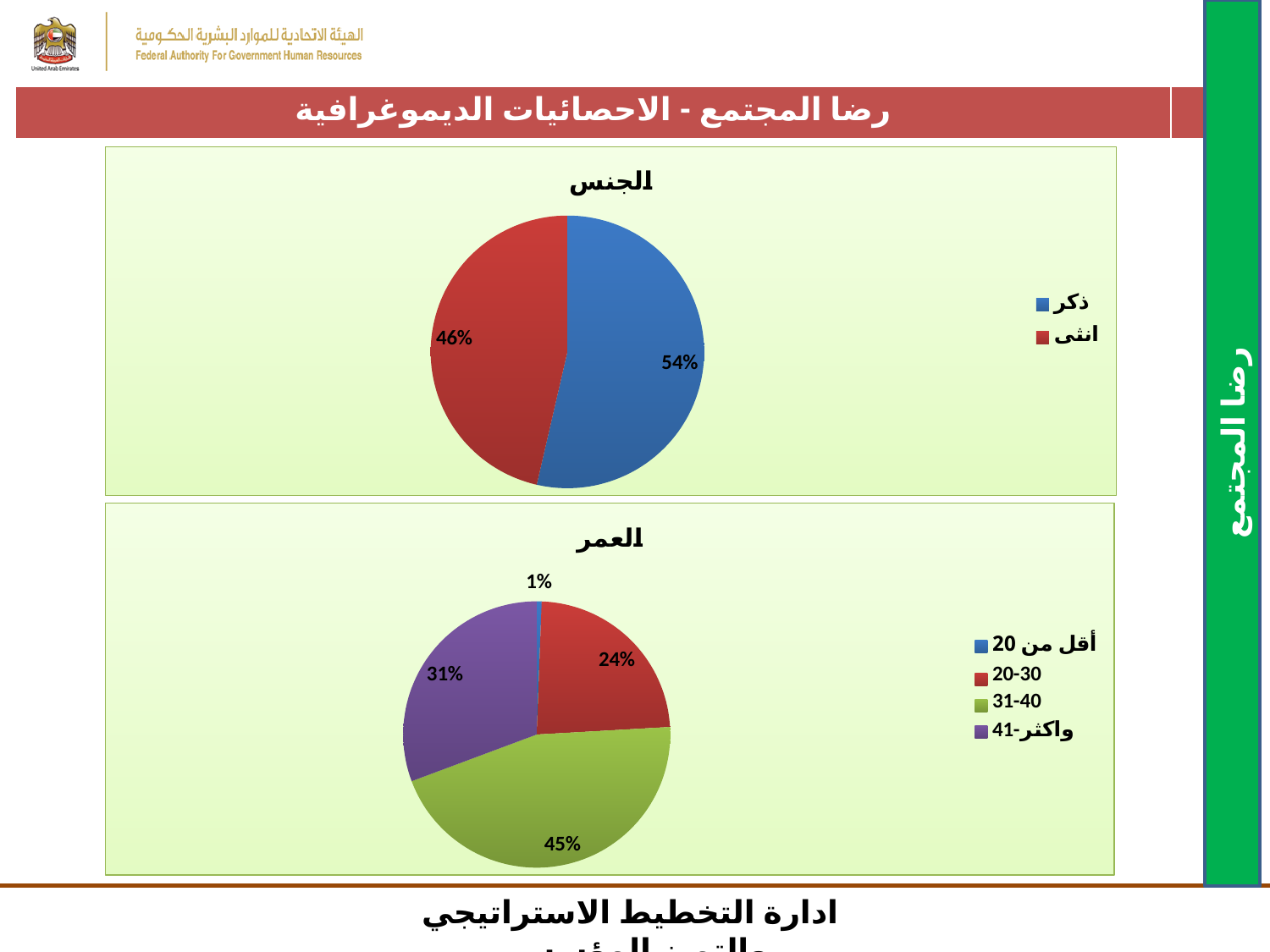
In the pie chart titled "الجنس", what percentage is shown for ذكر? 54% In the pie chart titled "العمر", which is larger: the share for 20-30 or the share for 41 واكثر? 41 واكثر In the pie chart titled "العمر", what percentage is shown for 31-40? 45% In the pie chart titled "العمر", which category has the smallest share? أقل من 20 In the pie chart titled "الجنس", what percentage is shown for انثى? 46% In the pie chart titled "العمر", what percentage is shown for 41 واكثر? 31% In the pie chart titled "العمر", what percentage is shown for 20-30? 24% In the pie chart titled "الجنس", what is the difference in percentage points between ذكر and انثى? 8 In the pie chart titled "الجنس", which category has the larger share? ذكر What type of chart is the chart titled "الجنس"? Pie chart In the pie chart titled "العمر", which category has the largest share? 31-40 How many categories does the legend of the pie chart titled "العمر" list? 4